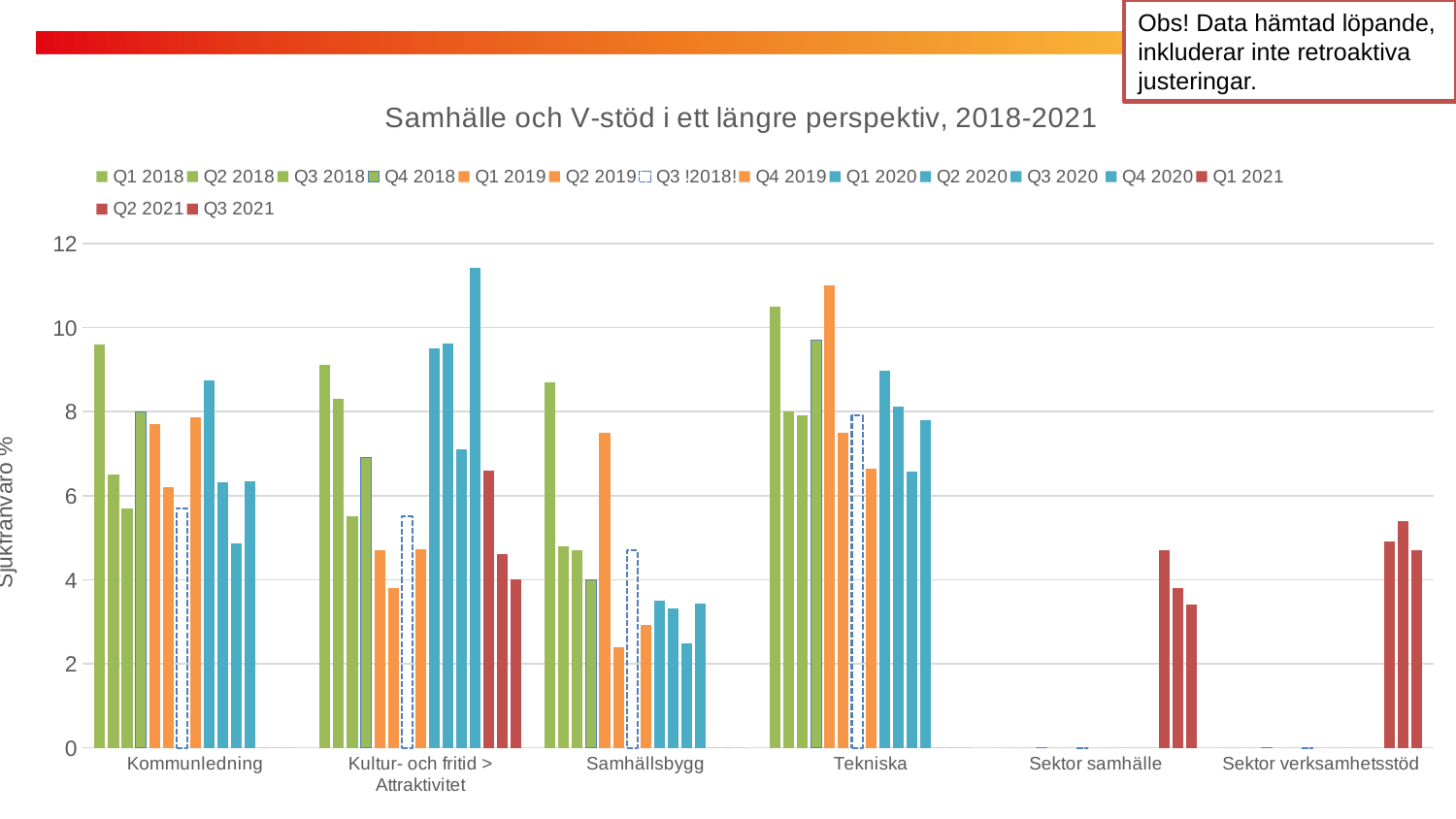
Which is larger: the Q1 2018 value for Kommunledning or the Q1 2018 value for Samhällsbygg? Kommunledning Within the Samhällsbygg category, which series has the highest value? Q1 2018 Is the value for Q2 2021 in Sektor verksamhetsstöd greater or less than 4? greater Is the value for Q1 2018 in Kommunledning greater or less than 8? greater Is the value for Q3 2021 in Sektor samhälle greater or less than 4? less What is the title of the chart? Samhälle och V-stöd i ett längre perspektiv, 2018-2021 How many categories are shown along the x axis of the chart? 6 What is the label on the vertical axis of the chart? Sjukfrånvaro % How many series does the chart's legend list? 15 What kind of chart is shown on the slide? bar chart